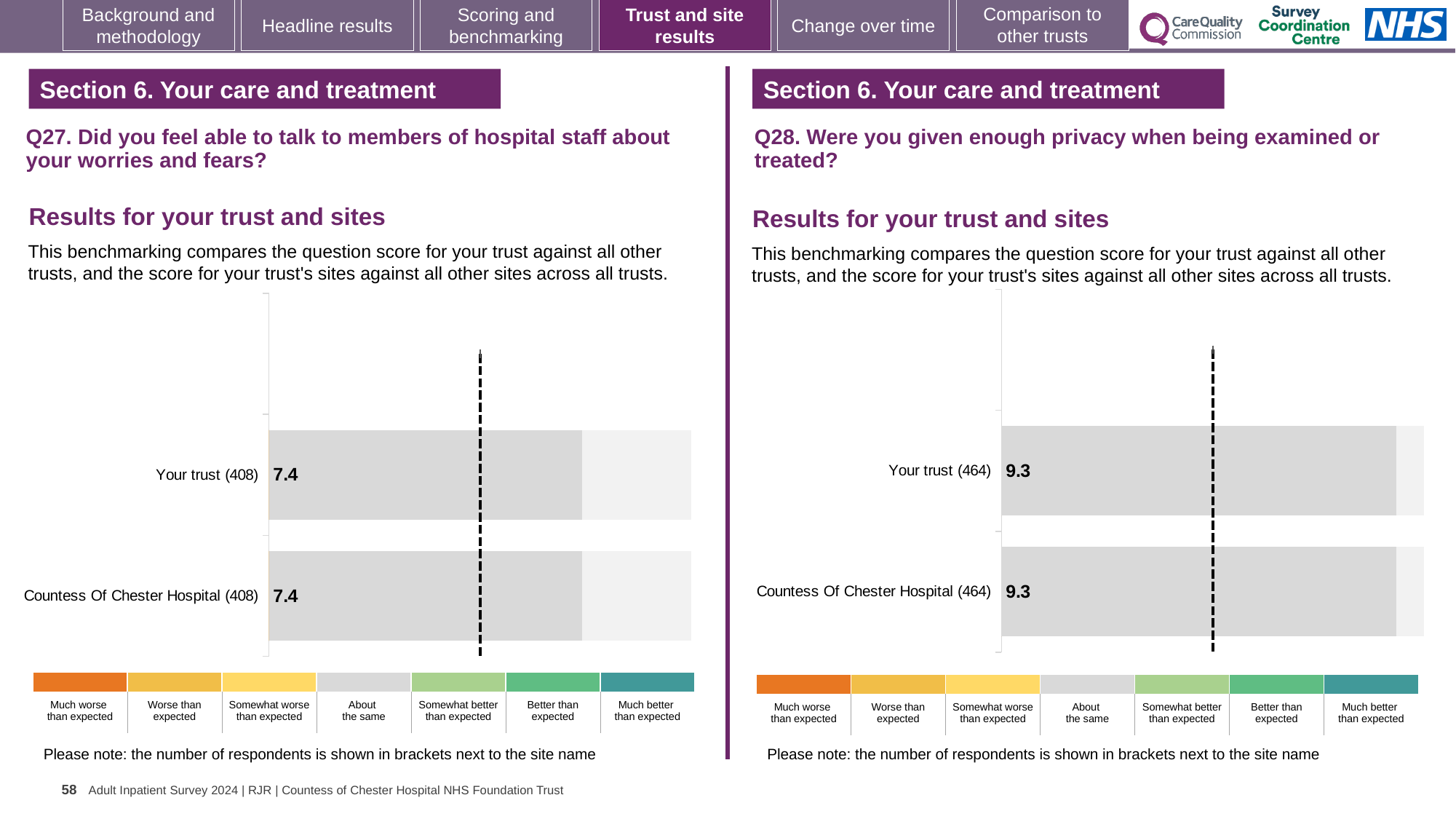
On the Q28 chart (right), what is the score for Countess Of Chester Hospital? 9.3 Is the score for Your trust on the Q28 chart (right) larger or smaller than the score for Your trust on the Q27 chart (left)? Larger What kind of chart is used for the Q27 results on the left? Bar chart How many bars are plotted on the Q28 chart (right)? 2 On the Q28 chart (right), what is the score for Your trust? 9.3 On the Q28 chart (right), how many respondents are shown in brackets next to Countess Of Chester Hospital? 464 How many bars are plotted on the Q27 chart (left)? 2 On the Q28 chart (right), what is the difference between the score for Your trust and the score for Countess Of Chester Hospital? 0 On the Q27 chart (left), how many respondents are shown in brackets next to Your trust? 408 On the Q27 chart (left), what is the difference between the score for Your trust and the score for Countess Of Chester Hospital? 0 On the Q27 chart (left), what is the score for Your trust? 7.4 On the Q27 chart (left), what is the score for Countess Of Chester Hospital? 7.4